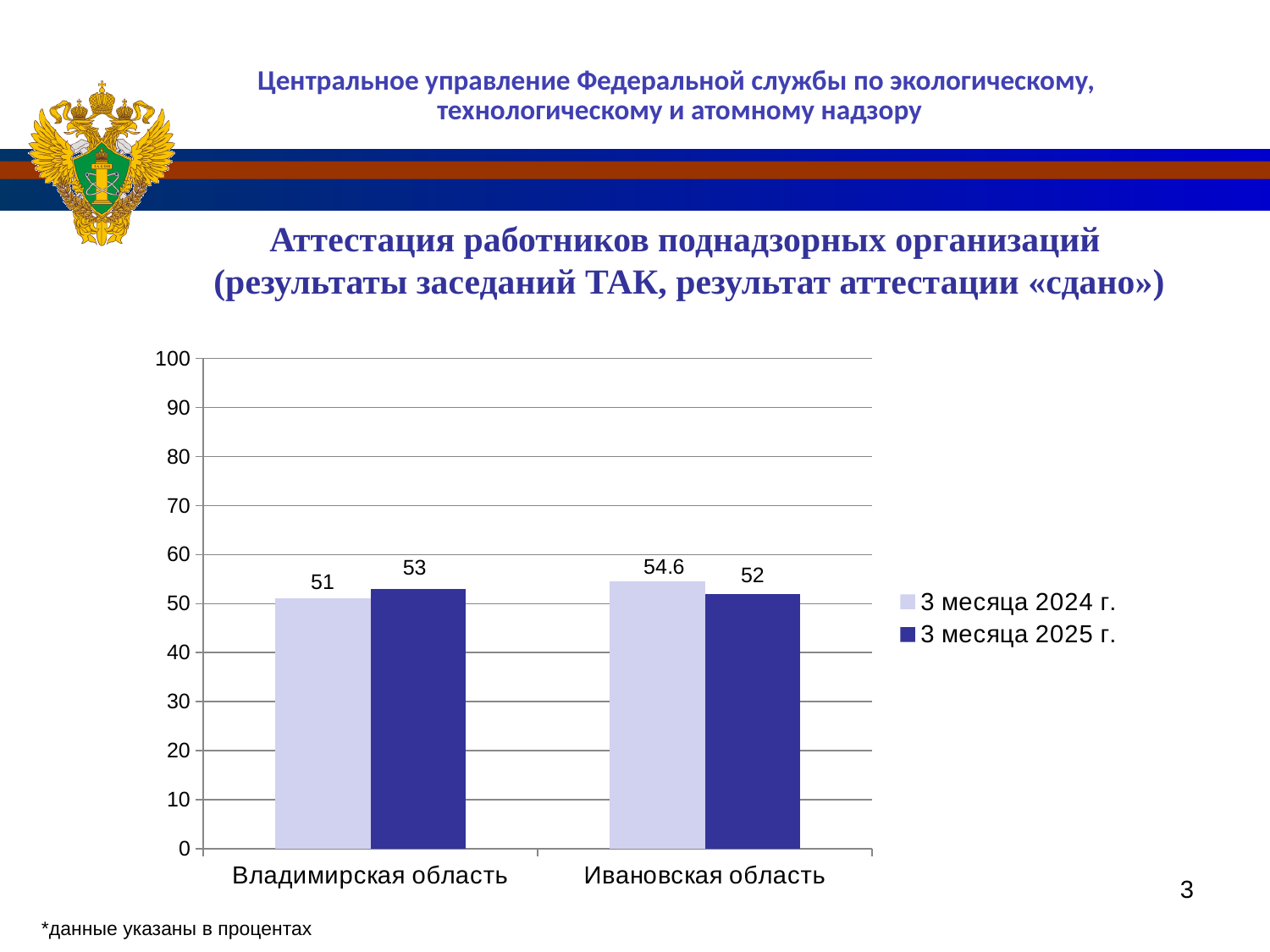
Which category has the highest value in the series 3 месяца 2024 г.? Ивановская область Which category has the lowest value in the series 3 месяца 2025 г.? Ивановская область Which is larger for Ивановская область: the 3 месяца 2024 г. value or the 3 месяца 2025 г. value? 3 месяца 2024 г. What is the value for Владимирская область in the series 3 месяца 2024 г.? 51 What is the value for Ивановская область in the series 3 месяца 2025 г.? 52 How many categories are shown on the x axis? 2 How many series does the legend list? 2 What is the difference between the 3 месяца 2025 г. and 3 месяца 2024 г. values for Владимирская область? 2 What is the value for Владимирская область in the series 3 месяца 2025 г.? 53 What kind of chart is shown on the slide? Bar chart What is the difference between the 3 месяца 2024 г. and 3 месяца 2025 г. values for Ивановская область? 2.6 What is the value for Ивановская область in the series 3 месяца 2024 г.? 54.6